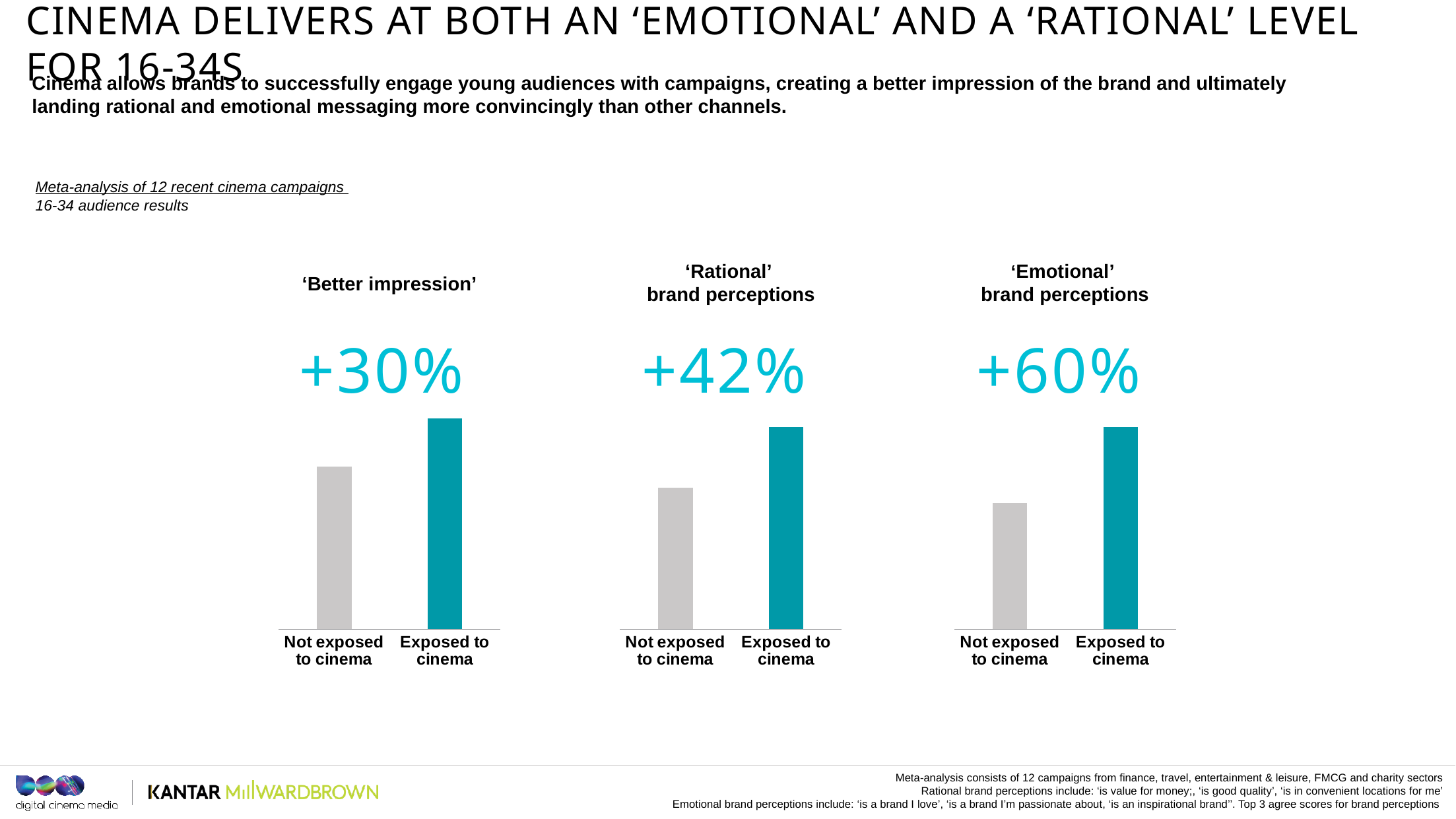
What uplift percentage is printed above the 'Rational' brand perceptions chart? +42% In the 'Rational' brand perceptions chart, which category has the lower bar? Not exposed to cinema In the 'Better impression' chart, which category has the higher bar? Exposed to cinema What uplift percentage is printed above the 'Better impression' chart? +30% In the 'Rational' brand perceptions chart, what colour is the 'Exposed to cinema' bar? teal How many separate bar charts are shown on the slide? 3 Which of the three charts shows the largest printed uplift percentage? 'Emotional' brand perceptions In the 'Better impression' chart, how many categories are shown on the x axis? 2 What type of chart is used under the 'Better impression' heading? bar chart In the 'Emotional' brand perceptions chart, is the bar for 'Exposed to cinema' larger or smaller than the bar for 'Not exposed to cinema'? larger Which of the three charts shows the smallest printed uplift percentage? 'Better impression' What uplift percentage is printed above the 'Emotional' brand perceptions chart? +60%